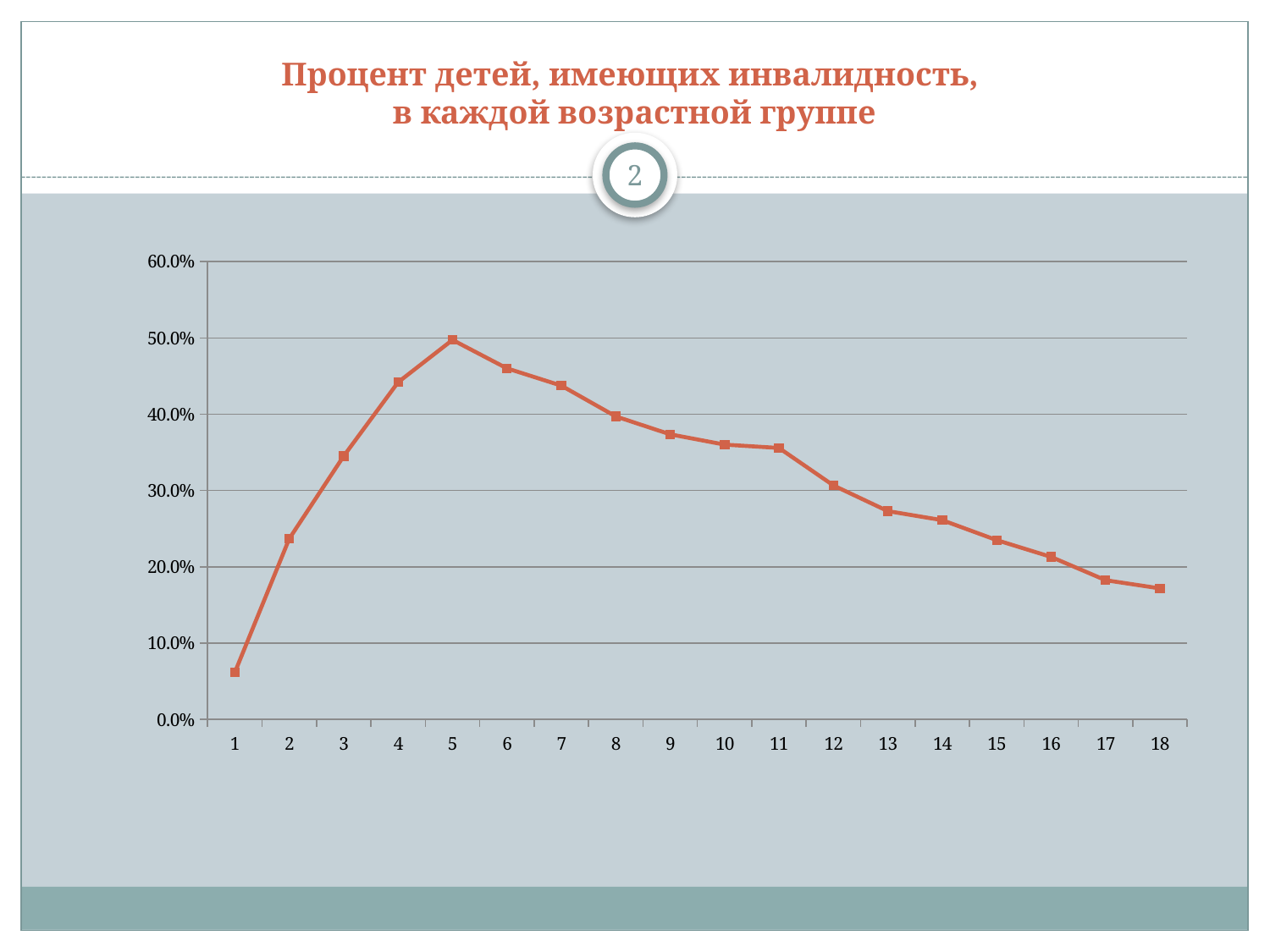
Which age group has a higher value, 4 or 9? 4 How do the values change from age group 5 to age group 18? they fall What kind of chart is shown on the slide? line chart Is the value for age group 18 greater or less than 20%? less What is the title of the chart on the slide? Процент детей, имеющих инвалидность, в каждой возрастной группе Is the value for age group 1 greater or less than 10%? less Is the value for age group 4 greater or less than 40%? greater At which age group is the percentage of children with a disability lowest? 1 Which age group has a higher value, 17 or 2? 2 How many age groups (points) are plotted along the x axis? 18 At which age group is the percentage of children with a disability highest? 5